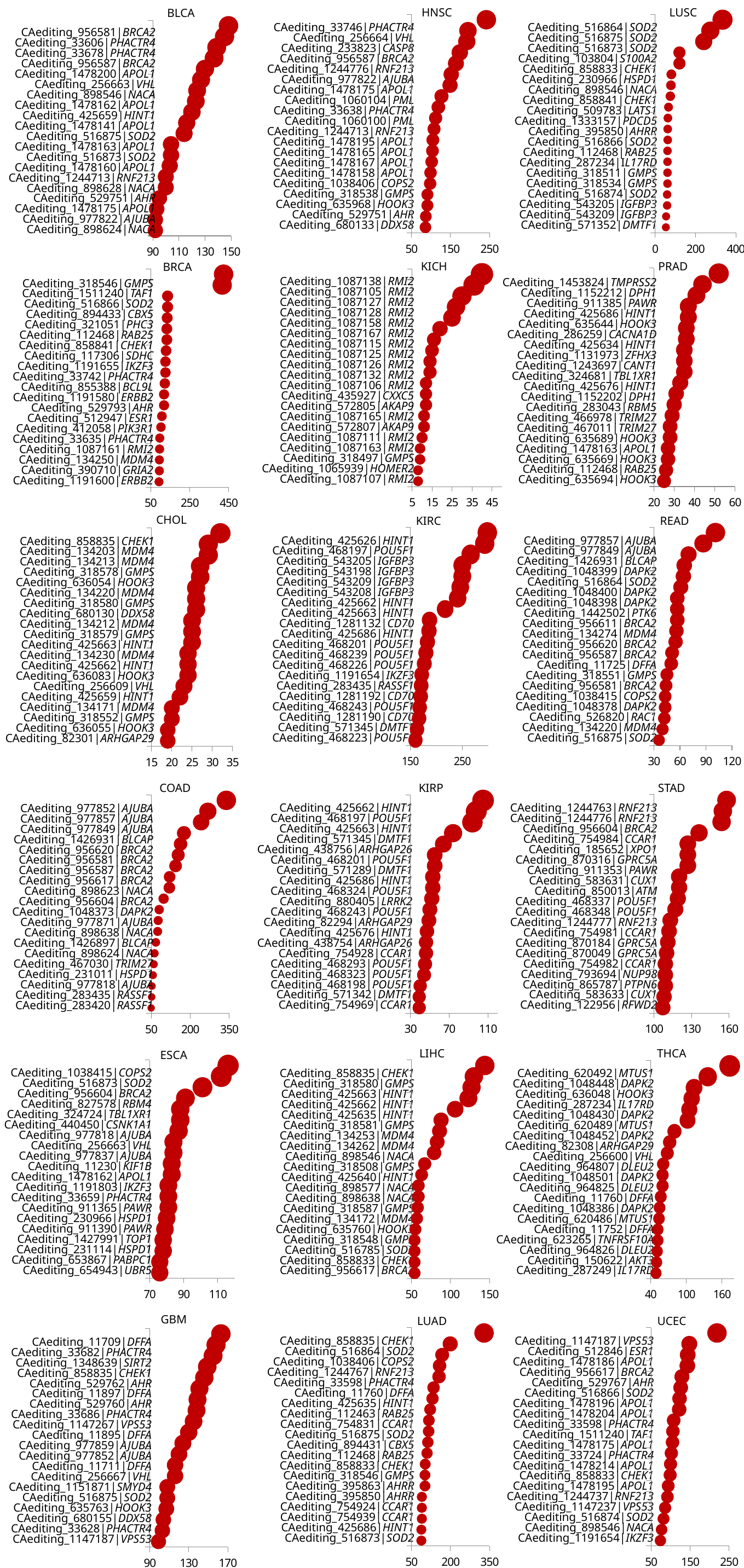
In the BLCA chart, is the value for CAediting_956581|BRCA2 greater or less than 130? greater In the HNSC chart, which category has the highest value? CAediting_33746|PHACTR4 What kind of chart is the BLCA chart? dot plot In the KICH chart, which category has the lowest value? CAediting_1087107|RMI2 In the BLCA chart, which category has the highest value? CAediting_956581|BRCA2 What colour are the dots in the charts? red In the LUSC chart, is the value for CAediting_571352|DMTF1 greater or less than 100? less In the KIRC chart, which is larger, the value for CAediting_425626|HINT1 or the value for CAediting_468223|POU5F1? CAediting_425626|HINT1 In the BLCA chart, which category has the lowest value? CAediting_898624|NACA How many categories are plotted in the BLCA chart? 20 In the COAD chart, is the value for CAediting_977852|AJUBA greater or less than 200? greater How many charts are shown on the slide? 18